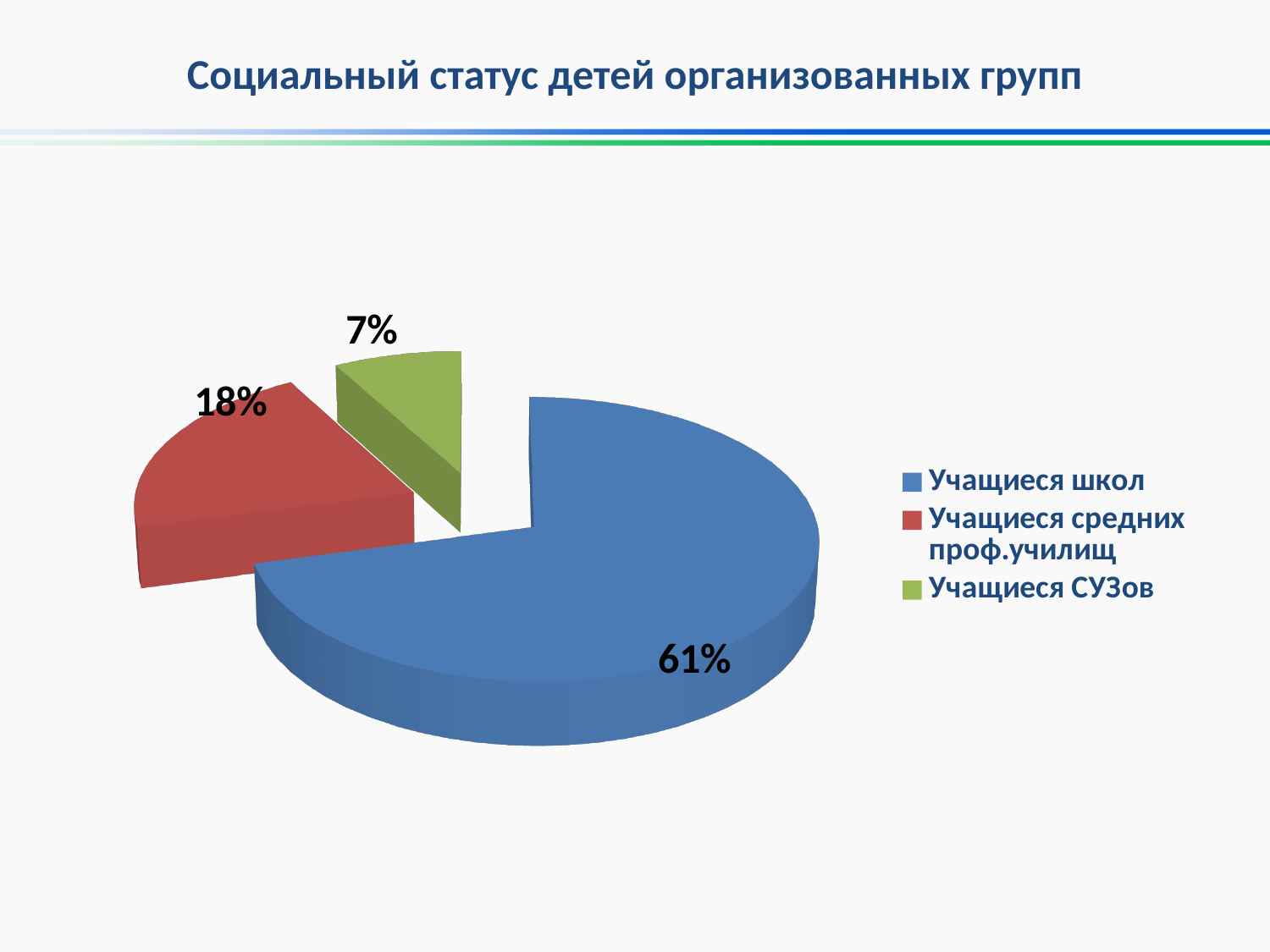
Which category has the largest slice of the pie? Учащиеся школ What share of the pie is labelled for Учащиеся средних проф.училищ? 18% What type of chart is shown on the slide? Pie chart Which is larger: the slice for Учащиеся средних проф.училищ or the slice for Учащиеся СУЗов? Учащиеся средних проф.училищ What share of the pie is labelled for Учащиеся СУЗов? 7% What colour is the slice for Учащиеся СУЗов? Green How many categories does the pie chart show? 3 Which category has the smallest slice of the pie? Учащиеся СУЗов What share of the pie is labelled for Учащиеся школ? 61% What is the difference in percentage points between Учащиеся школ and Учащиеся средних проф.училищ? 43 What is the title of the slide? Социальный статус детей организованных групп What is the difference in percentage points between Учащиеся средних проф.училищ and Учащиеся СУЗов? 11